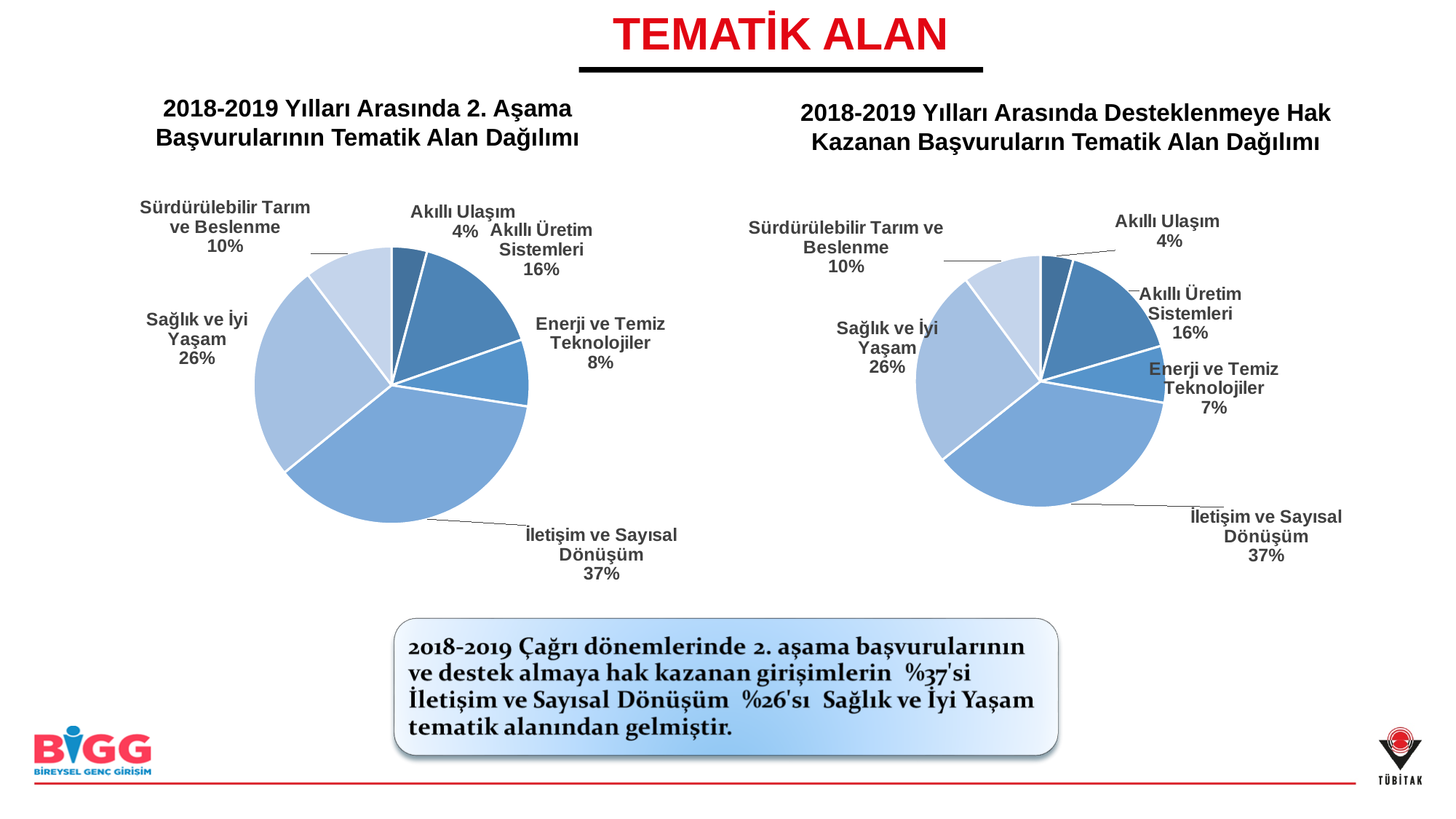
In the left pie chart, what share does Akıllı Üretim Sistemleri have? 16% In the right pie chart (Desteklenmeye Hak Kazanan Başvuruların Tematik Alan Dağılımı), what share does Enerji ve Temiz Teknolojiler have? 7% In the left pie chart, what share does Enerji ve Temiz Teknolojiler have? 8% In the right pie chart, which thematic area has the largest share? İletişim ve Sayısal Dönüşüm In the left pie chart, which thematic area has the smallest share? Akıllı Ulaşım In the left pie chart, what is the difference between the shares of Sağlık ve İyi Yaşam and Sürdürülebilir Tarım ve Beslenme? 16% In the right pie chart, which is larger: Akıllı Üretim Sistemleri or Sürdürülebilir Tarım ve Beslenme? Akıllı Üretim Sistemleri What is the title of the right pie chart? 2018-2019 Yılları Arasında Desteklenmeye Hak Kazanan Başvuruların Tematik Alan Dağılımı What type of chart is used on the left side of the slide? Pie chart How many slices does the right pie chart have? 6